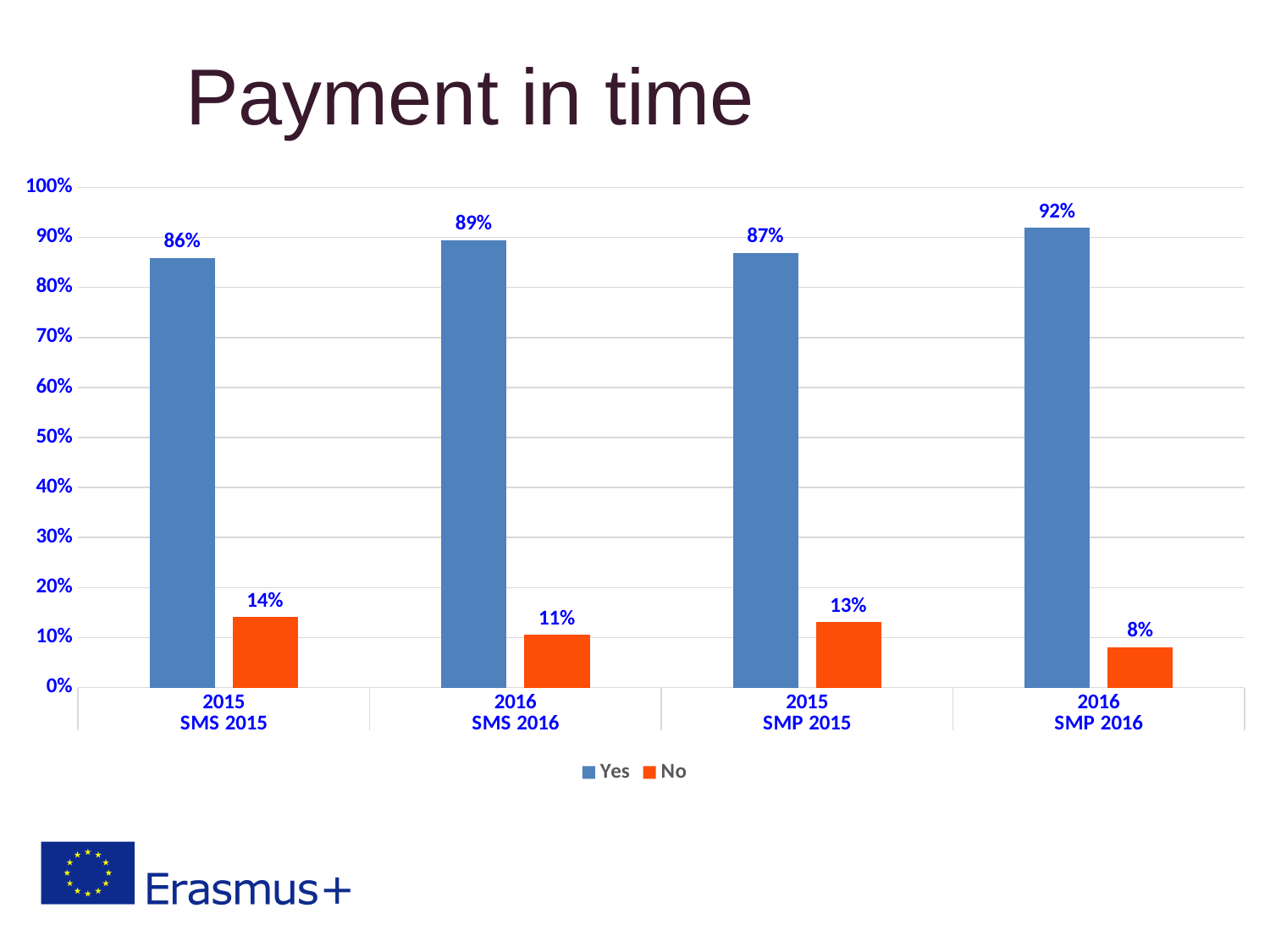
How many series does the legend list? 2 What kind of chart is shown on the slide? bar chart Which is larger: the "No" value for SMS 2015 or the "No" value for SMP 2015? SMS 2015 What is the "Yes" value for SMS 2015? 86% Is the "Yes" value for SMS 2016 greater or less than 80%? greater What is the difference between the "Yes" values for SMS 2016 and SMS 2015? 3% Which category has the highest "Yes" value? SMP 2016 What is the "No" value for SMP 2016? 8% What is the "Yes" value for SMP 2015? 87% Which category has the lowest "No" value? SMP 2016 How many categories are shown on the x axis? 4 What is the title of the slide? Payment in time